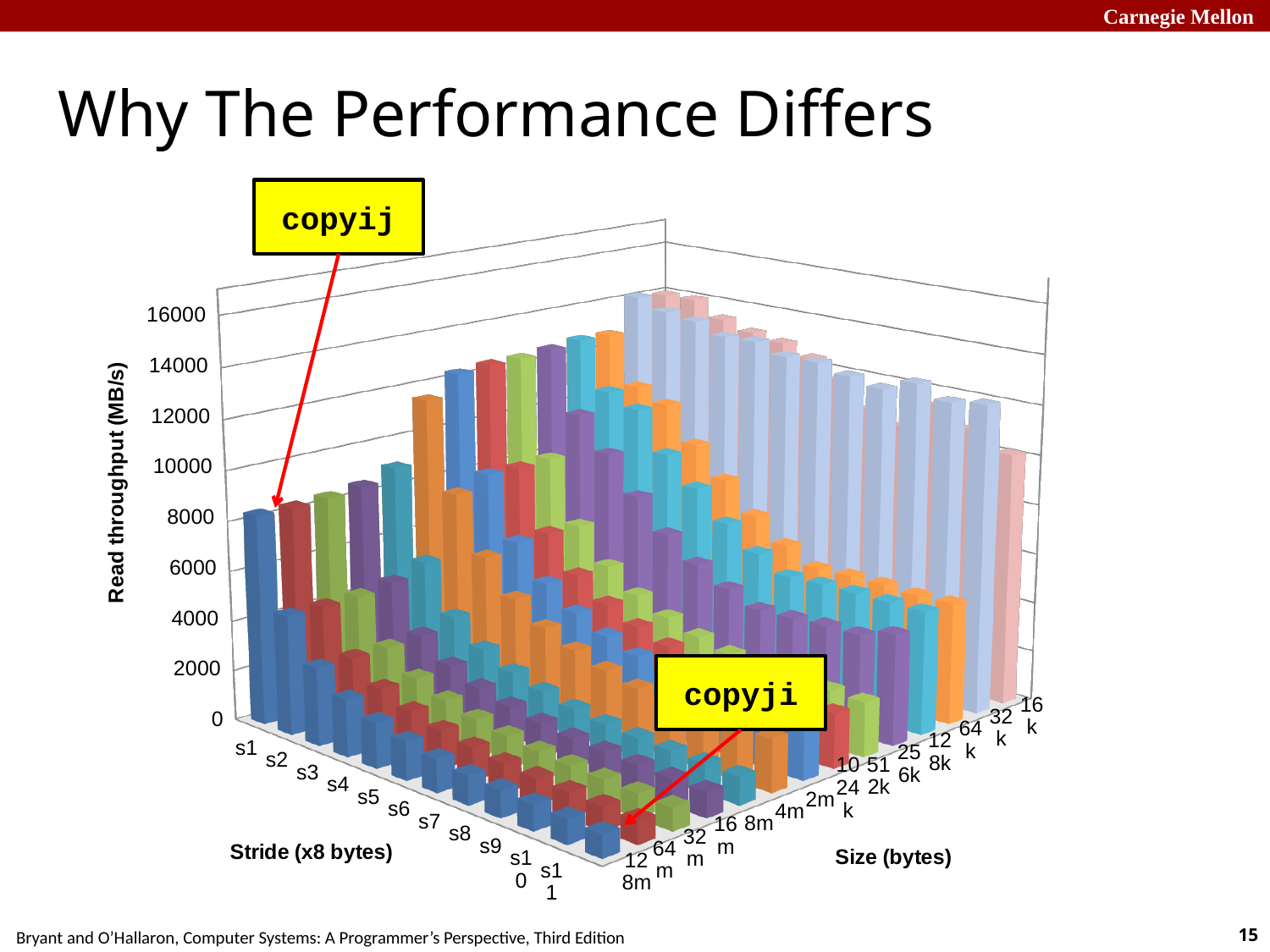
Is the bar labelled copyji (stride s11, size 128m) greater or less than 2000 MB/s? less Which has the higher read throughput, the bar labelled copyij or the bar labelled copyji? copyij What is the highest tick value shown on the read throughput axis? 16000 What kind of chart is shown on the slide? 3D bar chart What is the title of the vertical axis of the chart? Read throughput (MB/s) Is the bar labelled copyij (stride s1, size 128m) greater or less than 4000 MB/s? greater For stride s1, does read throughput rise or fall as size decreases from 128m to 16k? rise For size 128m, does read throughput rise or fall as stride increases from s1 to s11? fall How many size categories are shown along the size axis? 14 What are the two horizontal axis titles of the chart? Stride (x8 bytes) and Size (bytes) How many stride categories (s1, s2, ...) are shown along the stride axis? 11 Which stride and size combination does the copyij label point to? s1, 128m